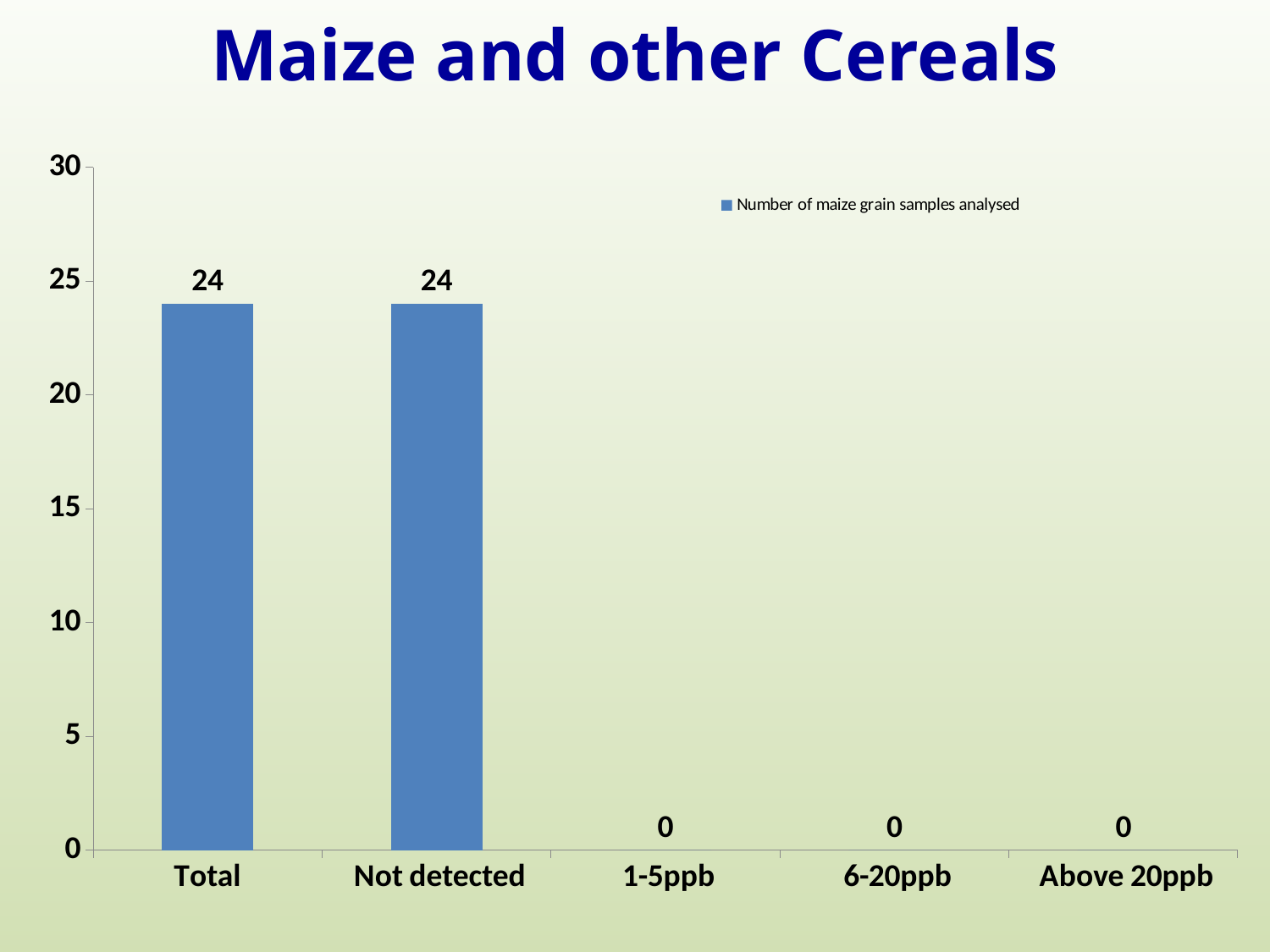
What is the value for Total? 24 What series name is shown in the legend? Number of maize grain samples analysed What is the title of the slide? Maize and other Cereals What kind of chart is shown on the slide? bar chart Is the value for Total greater or less than 20? greater What is the value for 1-5ppb? 0 What is the value for Above 20ppb? 0 What is the value for Not detected? 24 How many series does the legend list? 1 What is the difference between the values for Total and 6-20ppb? 24 How many categories are shown on the x axis? 5 Which is larger, the value for Not detected or the value for 1-5ppb? Not detected